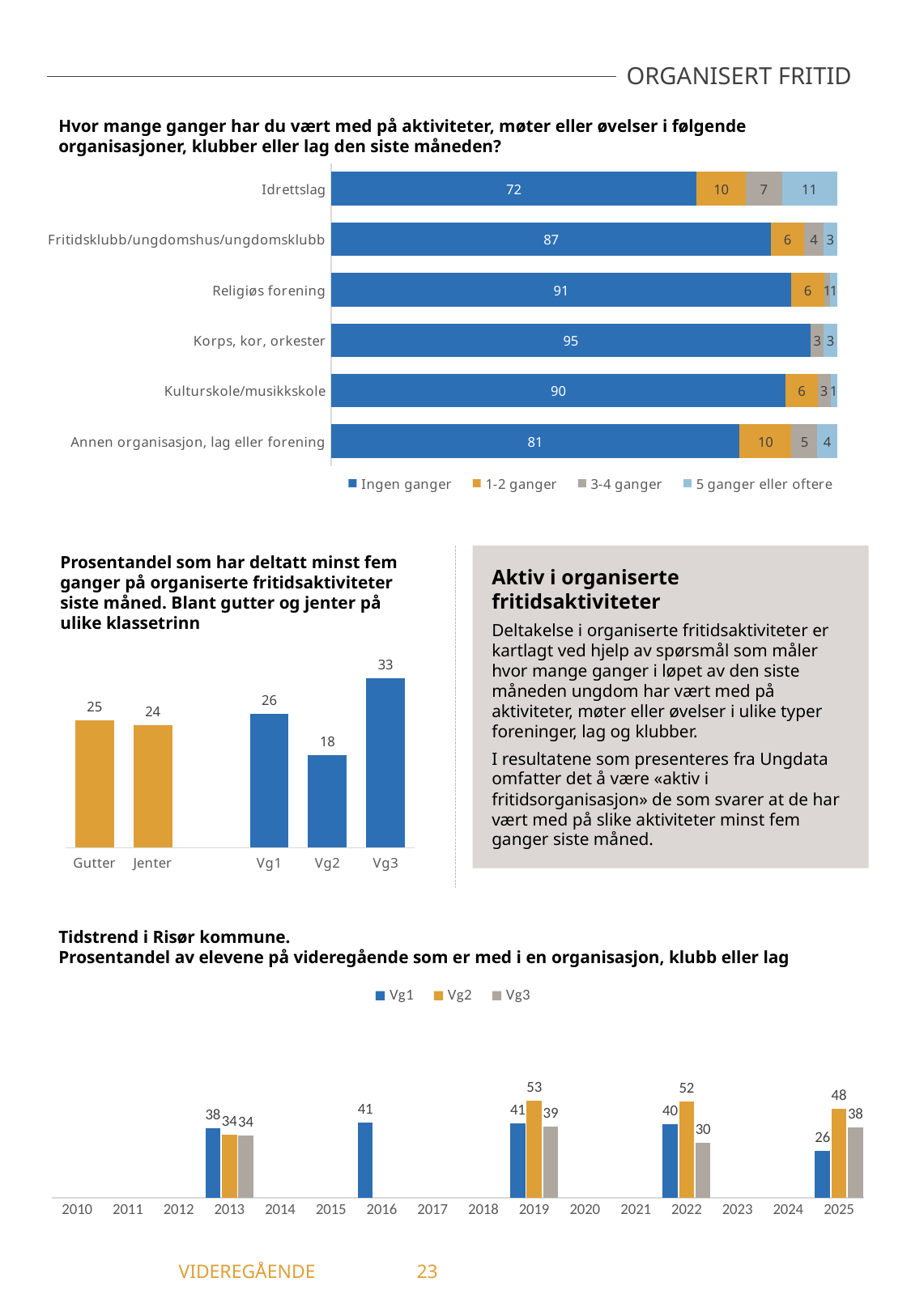
In the top chart (Hvor mange ganger har du vært med på aktiviteter...), what is the value for 'Ingen ganger' for Idrettslag? 72 In the bottom chart (Tidstrend i Risør kommune), what is the difference between the Vg2 and Vg3 values in 2022? 22 In the top chart (Hvor mange ganger har du vært med på aktiviteter...), which category has the highest 'Ingen ganger' value? Korps, kor, orkester In the middle-left chart (Prosentandel som har deltatt minst fem ganger...), what is the value for Vg2? 18 In the top chart (Hvor mange ganger har du vært med på aktiviteter...), what is the value for '5 ganger eller oftere' for Idrettslag? 11 In the bottom chart (Tidstrend i Risør kommune), what is the Vg2 value for 2019? 53 In the middle-left chart (Prosentandel som har deltatt minst fem ganger...), how many categories are shown? 5 In the top chart (Hvor mange ganger har du vært med på aktiviteter...), what is the difference between the 'Ingen ganger' values for Korps, kor, orkester and Idrettslag? 23 In the middle-left chart (Prosentandel som har deltatt minst fem ganger...), which category has the highest value? Vg3 In the top chart (Hvor mange ganger har du vært med på aktiviteter...), how many series does the legend list? 4 In the bottom chart (Tidstrend i Risør kommune), which is larger in 2025: Vg1 or Vg3? Vg3 What kind of chart is the bottom chart (Tidstrend i Risør kommune)? Bar chart